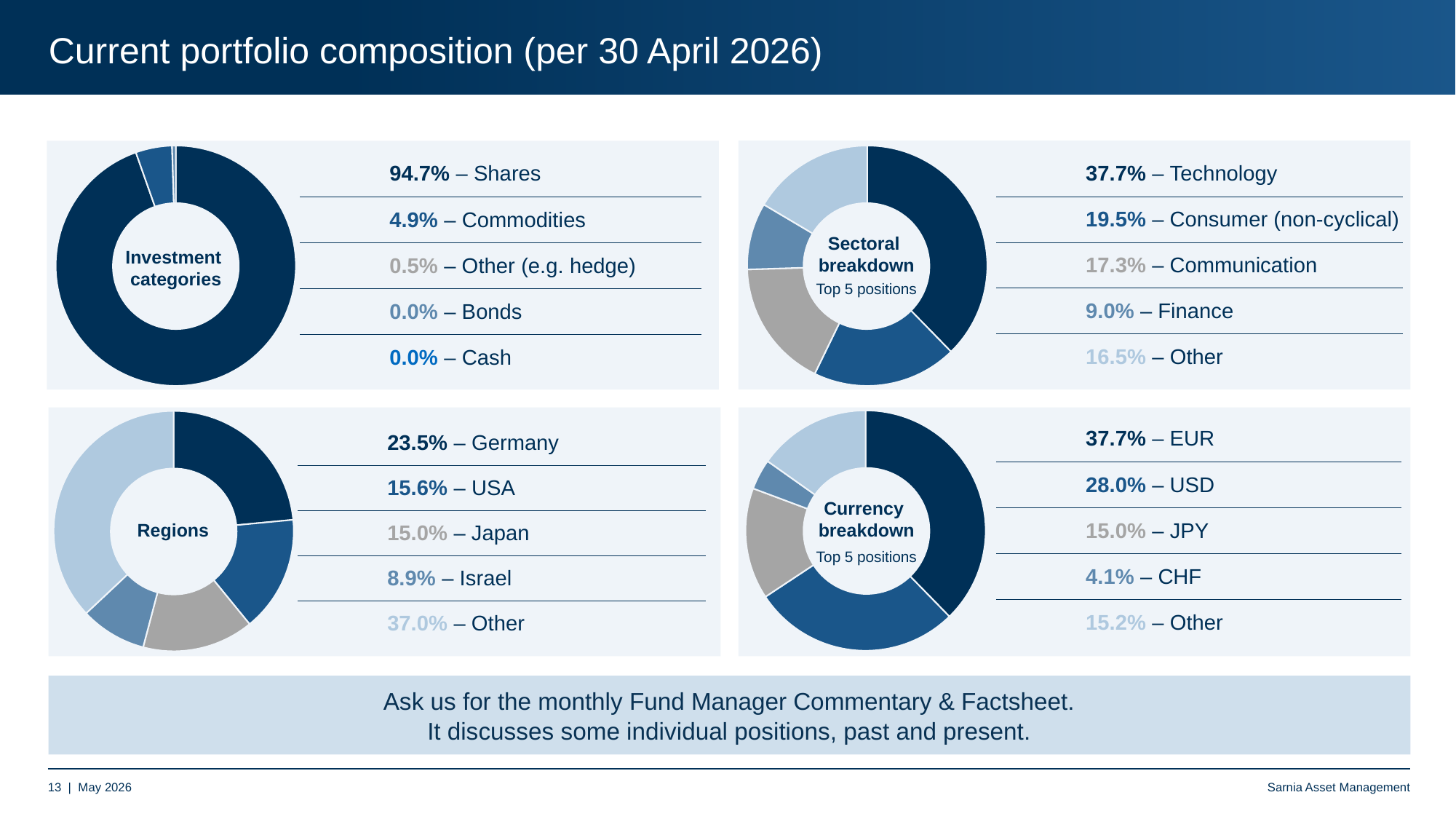
In the Investment categories chart, what share is Shares? 94.7% What type of chart is used for the Currency breakdown? Donut (pie) chart In the Sectoral breakdown chart, what share is Finance? 9.0% In the Regions chart, what share is Germany? 23.5% In the Regions chart, which named region (excluding Other) has the smallest share? Israel In the Currency breakdown chart, what share is USD? 28.0% In the Sectoral breakdown chart, which sector has the largest share? Technology How many charts are shown on the slide? 4 In the Regions chart, which is larger, USA or Japan? USA In the Sectoral breakdown chart, what is the difference between Technology and Consumer (non-cyclical)? 18.2% In the Investment categories chart, what share is Commodities? 4.9% In the Currency breakdown chart, what is the difference between EUR and USD? 9.7%